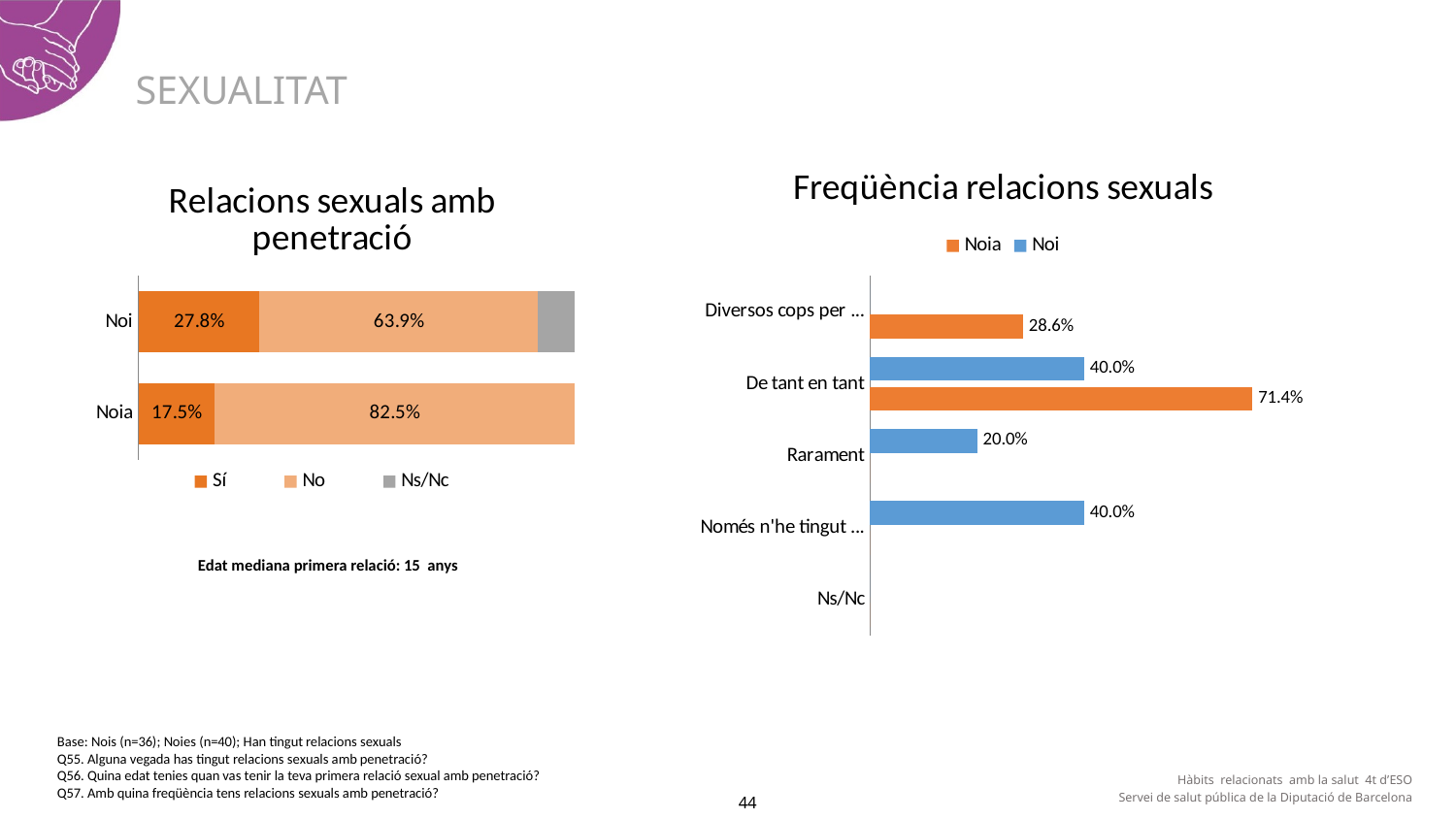
In the 'Relacions sexuals amb penetració' chart, what percentage of Noia answered No? 82.5% In the 'Relacions sexuals amb penetració' chart, which group has the larger No percentage, Noi or Noia? Noia In the 'Relacions sexuals amb penetració' chart, what is the difference between the Sí percentages for Noi and Noia? 10.3% In the 'Freqüència relacions sexuals' chart, what is the difference between Noia and Noi in the 'De tant en tant' category? 31.4% In the 'Freqüència relacions sexuals' chart, what is the value for Noi in the 'Rarament' category? 20.0% In the 'Freqüència relacions sexuals' chart, which category has the highest value for Noia? De tant en tant In the 'Relacions sexuals amb penetració' chart, what is the total of the Sí and No segments for Noia? 100.0% In the 'Freqüència relacions sexuals' chart, how many categories are shown on the vertical axis? 5 In the 'Relacions sexuals amb penetració' chart, how many series does the legend list? 3 In the 'Relacions sexuals amb penetració' chart, what percentage of Noi answered Sí? 27.8% In the 'Freqüència relacions sexuals' chart, what is the value for Noia in the 'De tant en tant' category? 71.4% What type of chart is 'Freqüència relacions sexuals'? Bar chart